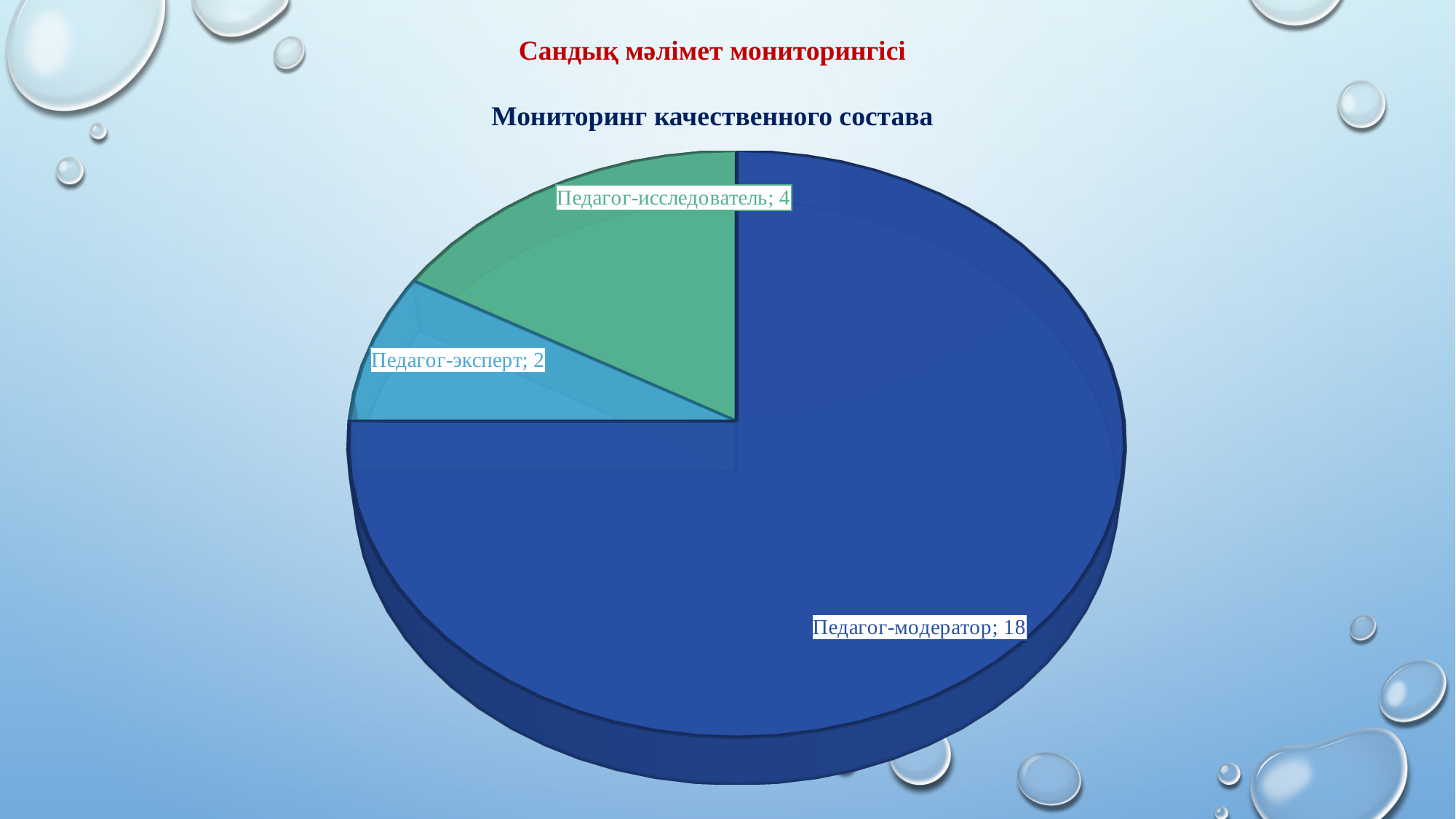
What kind of chart is shown on the slide? Pie chart Which category has the largest slice? Педагог-модератор What is the difference between the values for Педагог-модератор and Педагог-исследователь? 14 How many categories does the pie chart show? 3 What is the value for Педагог-модератор? 18 What share of the pie does Педагог-модератор represent? 75% What is the value for Педагог-эксперт? 2 What is the title of the chart? Мониторинг качественного состава What is the value for Педагог-исследователь? 4 What is the total of all slices in the pie chart? 24 Which category has the smallest slice? Педагог-эксперт Which is larger, Педагог-исследователь or Педагог-эксперт? Педагог-исследователь